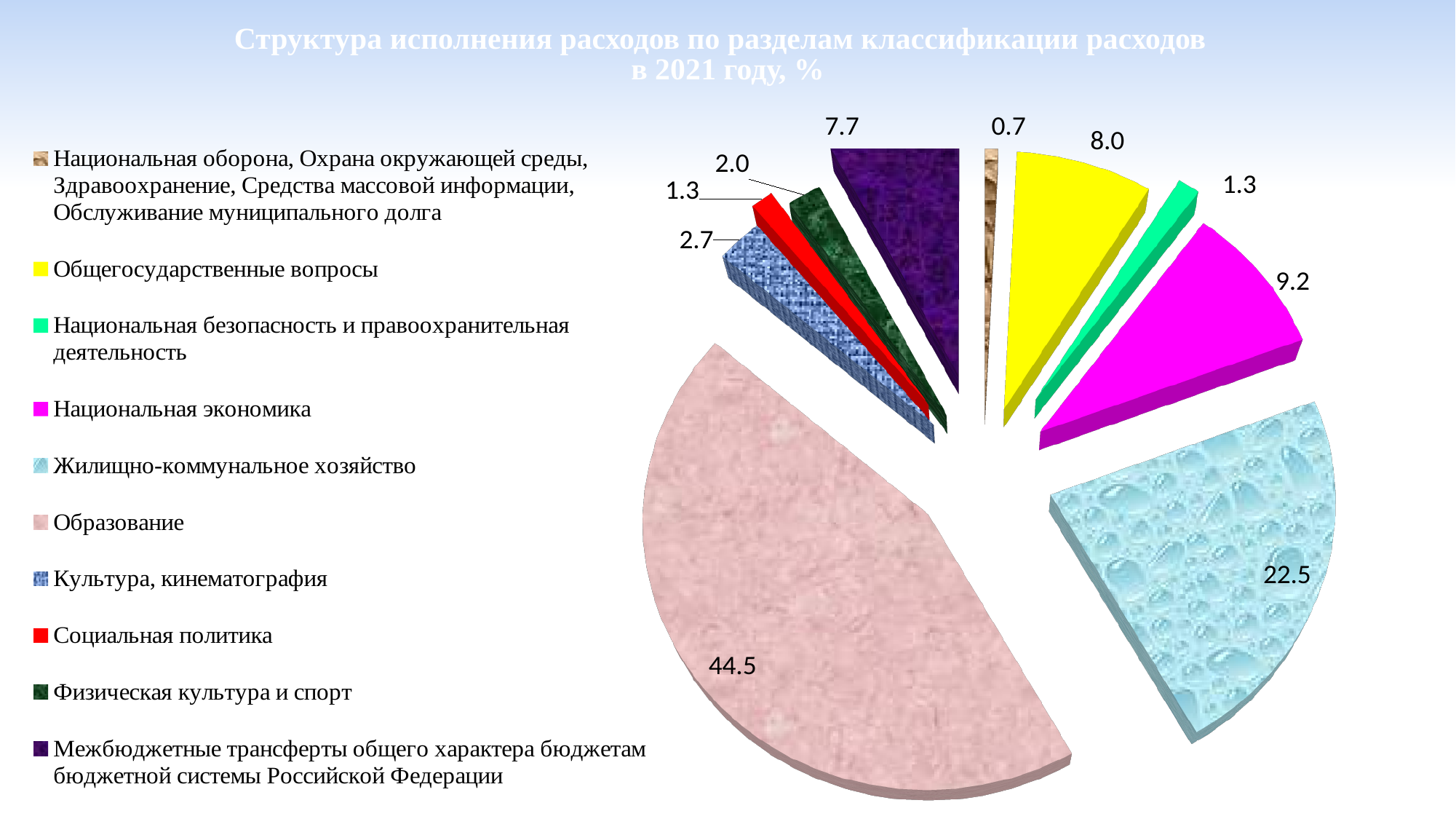
What is the difference between the values for Образование and Жилищно-коммунальное хозяйство? 22.0 What is the value for Общегосударственные вопросы? 8.0 Which is larger, the value for Национальная экономика or the value for Общегосударственные вопросы? Национальная экономика Which category has the smallest share of the pie? Национальная оборона, Охрана окружающей среды, Здравоохранение, Средства массовой информации, Обслуживание муниципального долга Which category has the largest share of the pie? Образование What is the value for Жилищно-коммунальное хозяйство? 22.5 How many categories does the legend list? 10 What is the value for Культура, кинематография? 2.7 What kind of chart is shown on the slide? pie chart What is the value for Образование? 44.5 What is the value for Межбюджетные трансферты общего характера бюджетам бюджетной системы Российской Федерации? 7.7 What is the value for Национальная экономика? 9.2